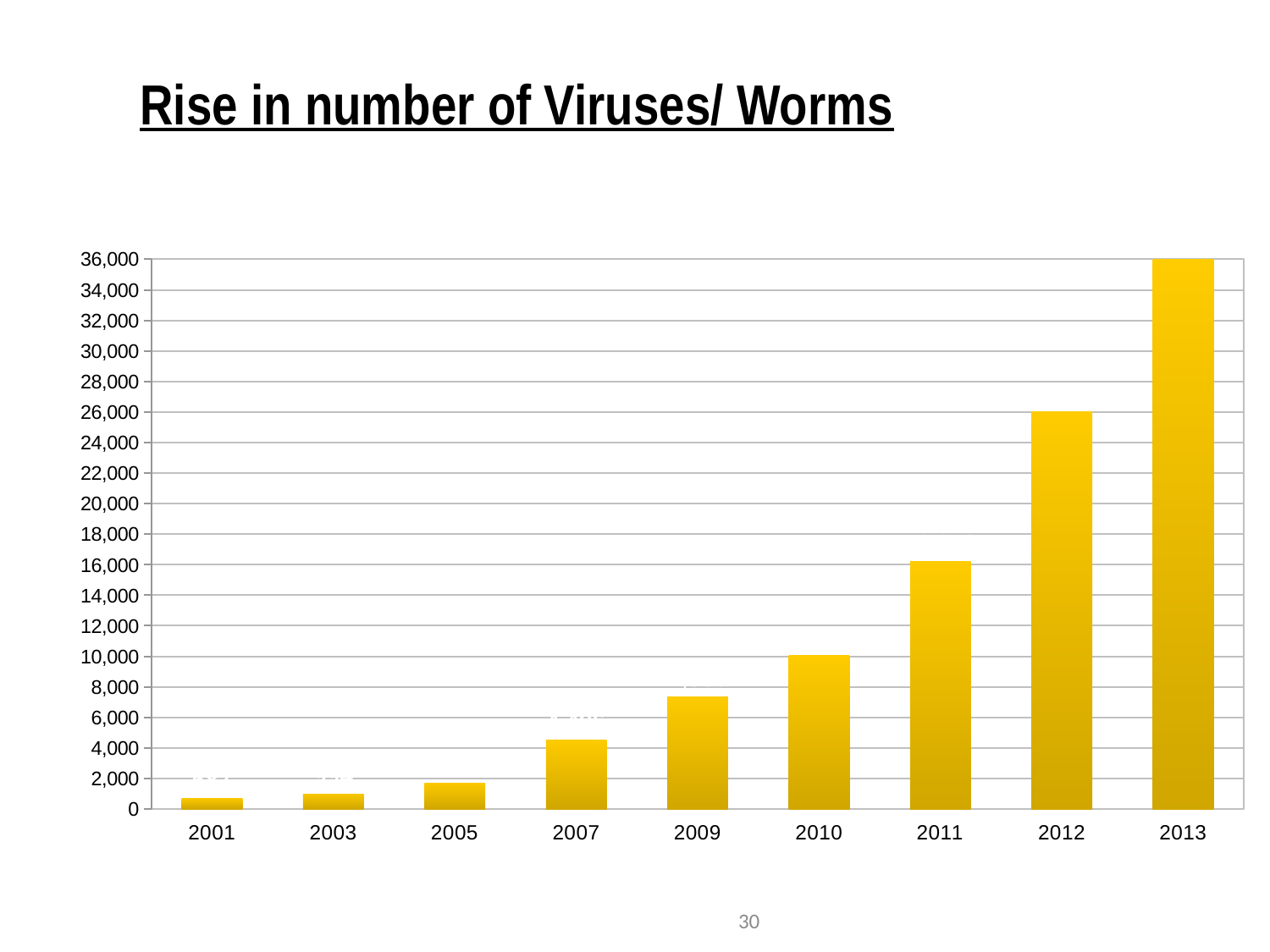
Do the values rise or fall from 2001 to 2013 along the x axis? rise Is the value for 2011 greater or less than 20,000? less What kind of chart is shown on the slide? bar chart Is the value for 2013 greater or less than 30,000? greater Is the value for 2012 greater or less than 20,000? greater Which is larger, the value for 2009 or the value for 2011? 2011 Which year has the lowest bar in the chart? 2001 Which year has the highest bar in the chart? 2013 How many years are shown on the x axis of the chart? 9